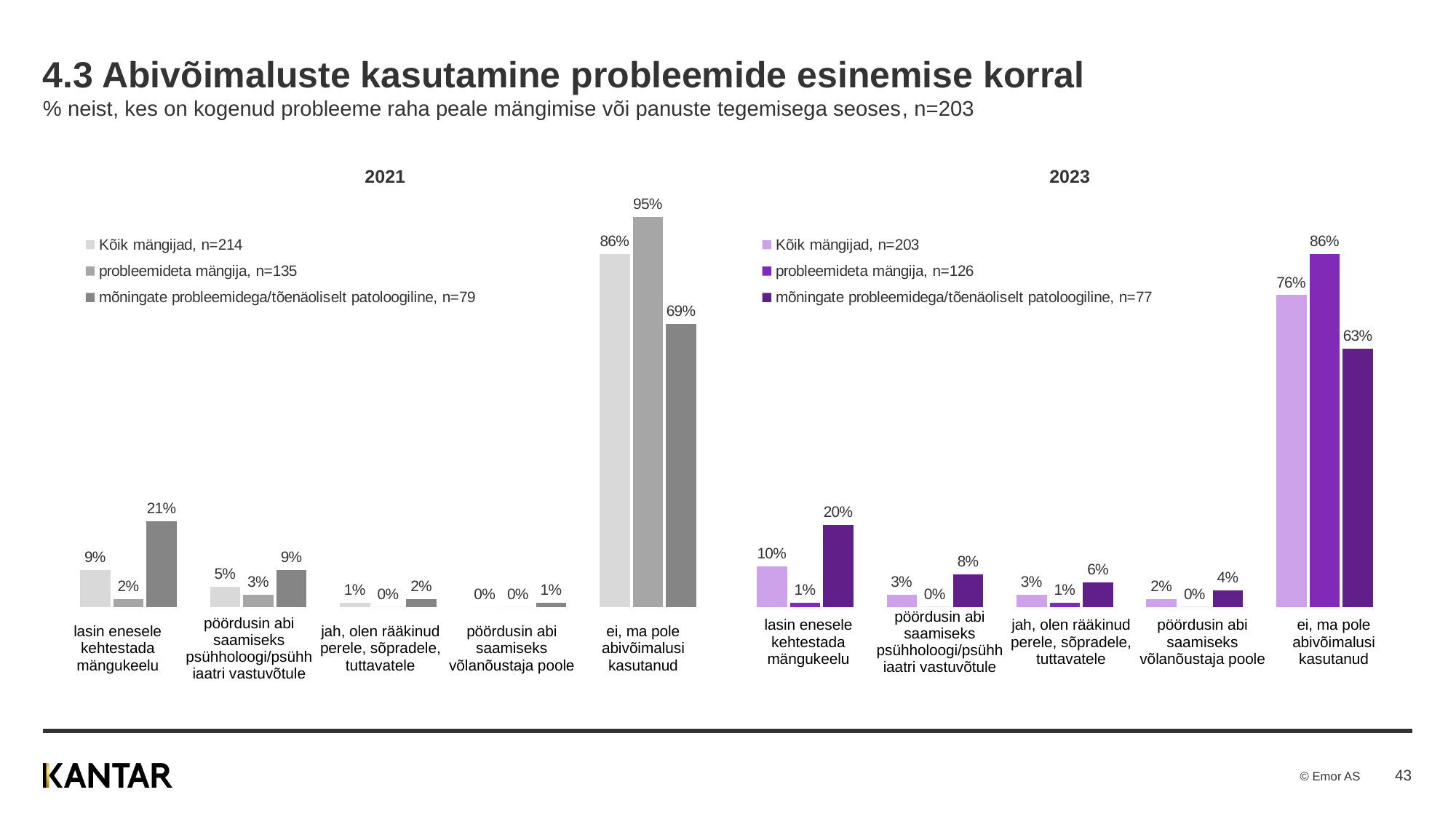
In the 2023 chart, what is the value for 'Kõik mängijad, n=203' in the category 'pöördusin abi saamiseks võlanõustaja poole'? 2% What kind of chart is the 2023 chart? bar chart In the 2021 chart, which is larger in the category 'pöördusin abi saamiseks psühholoogi/psühhiaatri vastuvõtule': 'Kõik mängijad, n=214' or 'mõningate probleemidega/tõenäoliselt patoloogiline, n=79'? mõningate probleemidega/tõenäoliselt patoloogiline, n=79 In the 2021 chart, what is the value for 'Kõik mängijad, n=214' in the category 'ei, ma pole abivõimalusi kasutanud'? 86% How many categories are shown on the x axis of the 2023 chart? 5 How many series does the legend of the 2021 chart list? 3 In the 2023 chart, what is the value for 'probleemideta mängija, n=126' in the category 'ei, ma pole abivõimalusi kasutanud'? 86% In the 2021 chart, what is the difference between 'mõningate probleemidega/tõenäoliselt patoloogiline, n=79' and 'Kõik mängijad, n=214' in the category 'lasin enesele kehtestada mängukeelu'? 12% What is the title of the chart on the left side of the slide? 2021 In the 2021 chart, which category has the highest value for 'mõningate probleemidega/tõenäoliselt patoloogiline, n=79'? ei, ma pole abivõimalusi kasutanud In the 2023 chart, what is the value for 'mõningate probleemidega/tõenäoliselt patoloogiline, n=77' in the category 'lasin enesele kehtestada mängukeelu'? 20% In the 2023 chart, what is the difference between 'probleemideta mängija, n=126' and 'mõningate probleemidega/tõenäoliselt patoloogiline, n=77' in the category 'ei, ma pole abivõimalusi kasutanud'? 23%